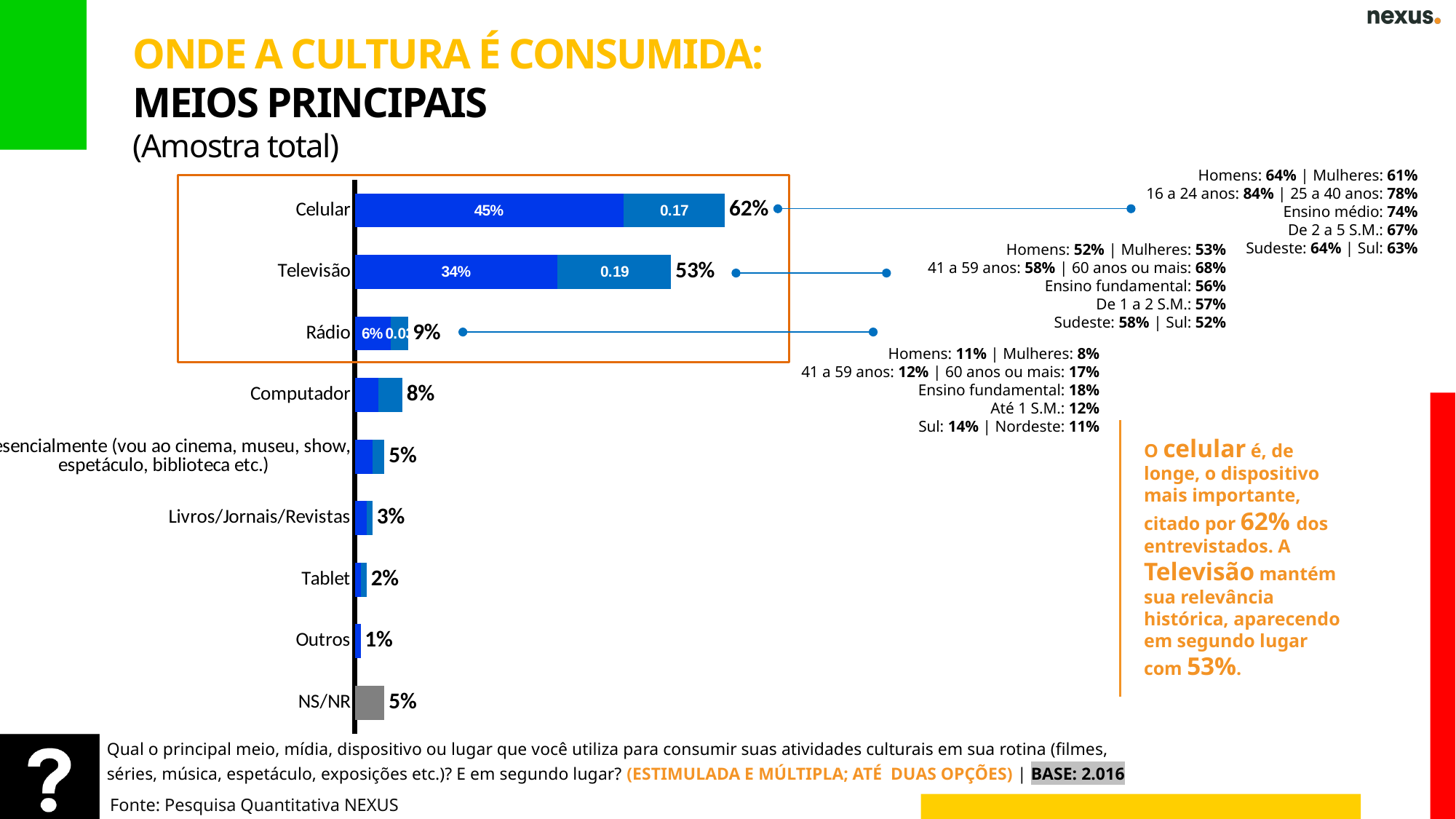
What is the difference between the total values for Celular and Televisão? 9 percentage points How many categories are shown in the chart? 9 What is the total value shown for Televisão in the chart? 53% Which has a larger value, Rádio or Computador? Rádio Which category has the highest total value in the chart? Celular What is the total value shown for Celular in the chart? 62% What is the value shown for Tablet in the chart? 2% What is the value shown for Rádio in the chart? 9% What is the value shown for NS/NR in the chart? 5% Which category has the lowest value in the chart? Outros What is the value of the first (dark blue) segment of the Celular bar? 45% What is the value shown for Computador in the chart? 8%